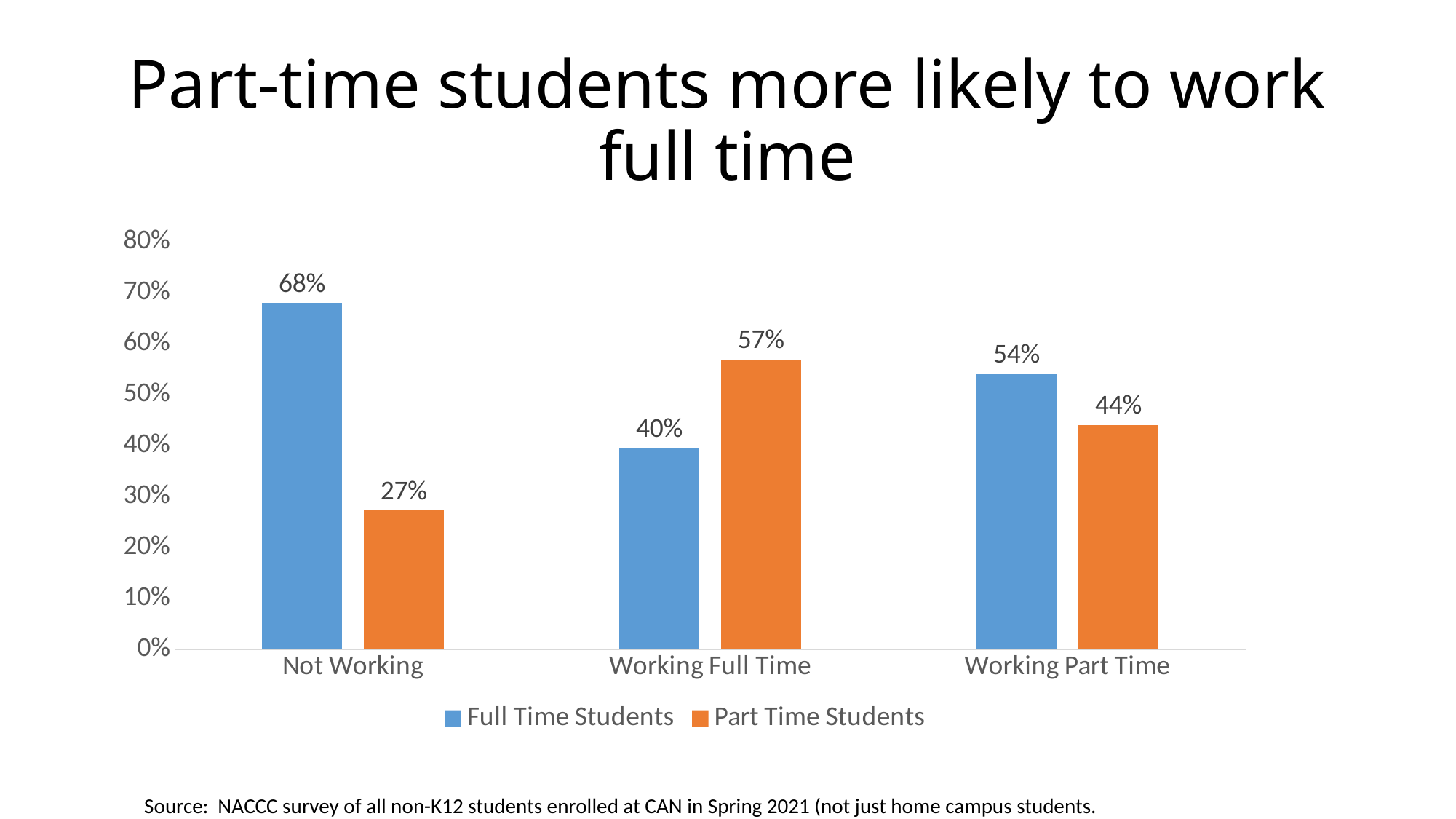
What percentage of Part Time Students are Working Full Time? 57% What is the value for Part Time Students in the Working Part Time category? 44% What is the value for Full Time Students in the Working Full Time category? 40% How many series does the legend list? 2 What percentage of Full Time Students are Not Working? 68% How many categories are shown on the x axis? 3 Which category has the lowest value for Part Time Students? Not Working What is the difference between Full Time Students and Part Time Students in the Not Working category? 41% What kind of chart is shown on the slide? Bar chart Which colour represents Part Time Students in the chart? Orange Which category has the highest value for Full Time Students? Not Working In the Working Full Time category, which series has the larger value, Full Time Students or Part Time Students? Part Time Students